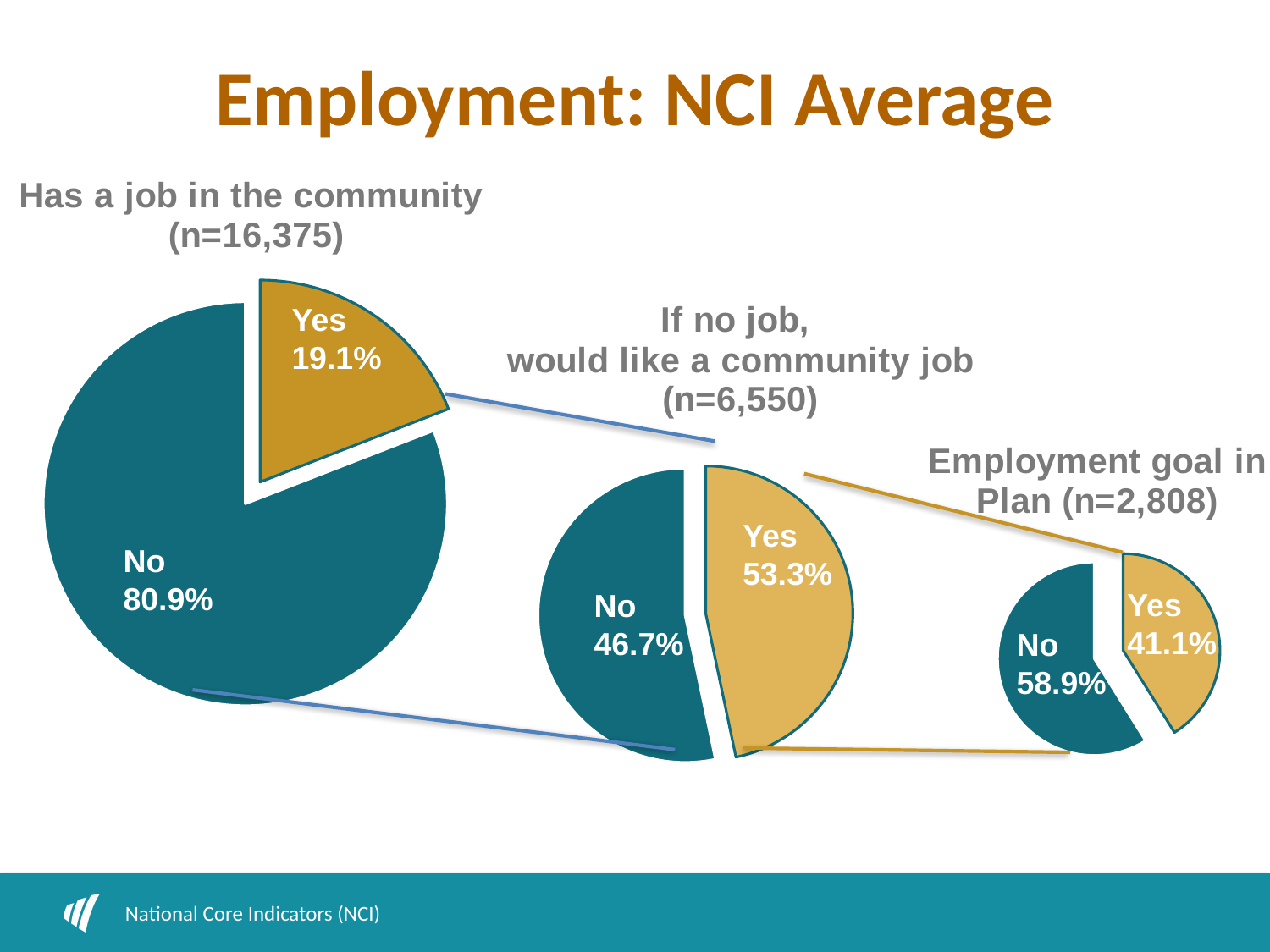
In the 'Employment goal in Plan' pie chart, what percentage answered Yes? 41.1% In the 'Has a job in the community' pie chart, what is the difference between the No and Yes percentages? 61.8% In the 'If no job, would like a community job' pie chart, which slice is the largest? Yes In the 'Employment goal in Plan' pie chart, which slice is the smallest? Yes How many pie charts are shown on the slide? 3 In the 'Employment goal in Plan' pie chart, what percentage answered No? 58.9% In the 'If no job, would like a community job' pie chart, what percentage answered No? 46.7% In the 'Has a job in the community' pie chart, what percentage answered No? 80.9% In the 'Has a job in the community' pie chart, what percentage answered Yes? 19.1% In the 'Has a job in the community' pie chart, which slice is larger, Yes or No? No What type of chart is used for 'Employment goal in Plan'? Pie chart In the 'If no job, would like a community job' pie chart, what percentage answered Yes? 53.3%